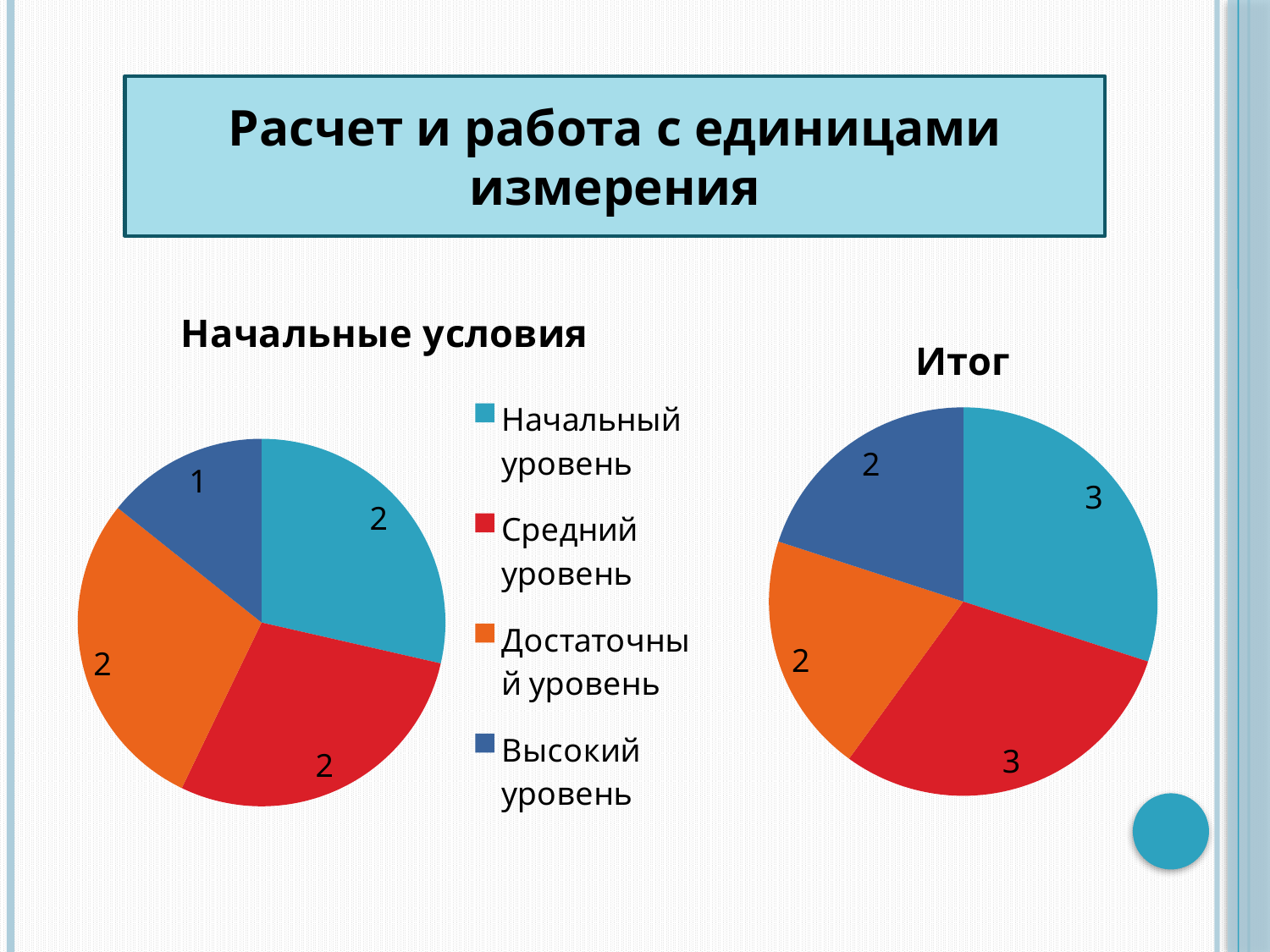
Which colour represents Достаточный уровень in the legend? orange In the "Итог" chart, what is the value for Достаточный уровень? 2 What is the difference between the value for Начальный уровень in the "Итог" chart and in the "Начальные условия" chart? 1 In the "Начальные условия" chart, which category has the smallest slice? Высокий уровень In the "Итог" chart, what is the value for Начальный уровень? 3 In the "Итог" chart, what share of the total does Начальный уровень represent? 30% How many slices does the "Итог" pie chart have? 4 In the "Начальные условия" chart, what is the value for Высокий уровень? 1 How many entries does the legend list? 4 In the "Начальные условия" chart, what is the value for Средний уровень? 2 What type of chart is used for "Начальные условия"? pie chart In the "Итог" chart, which is larger: Средний уровень or Высокий уровень? Средний уровень